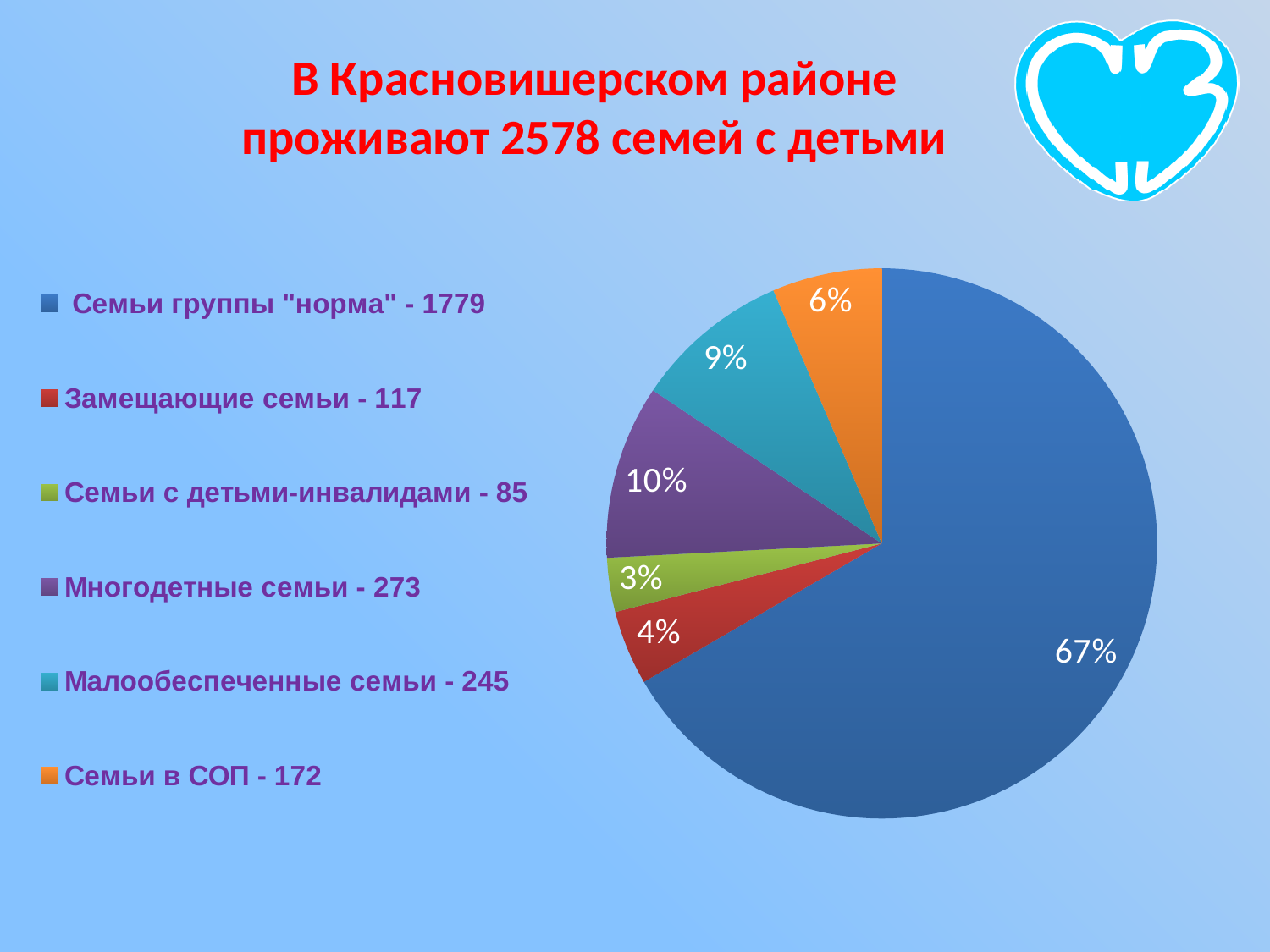
What is the difference between the number of Многодетные семьи and the number of Замещающие семьи shown in the legend? 156 What share of the pie does Семьи с детьми-инвалидами take? 3% Which category has the smallest slice of the pie? Семьи с детьми-инвалидами What colour is the slice for Семьи в СОП? orange What share of the pie does Семьи в СОП take? 6% How many categories does the pie chart have? 6 What share of the pie does Многодетные семьи take? 10% Which category has the largest slice of the pie? Семьи группы "норма" Which is larger: the slice for Малообеспеченные семьи or the slice for Семьи в СОП? Малообеспеченные семьи What kind of chart is shown on the slide? pie chart According to the legend, how many Малообеспеченные семьи are there? 245